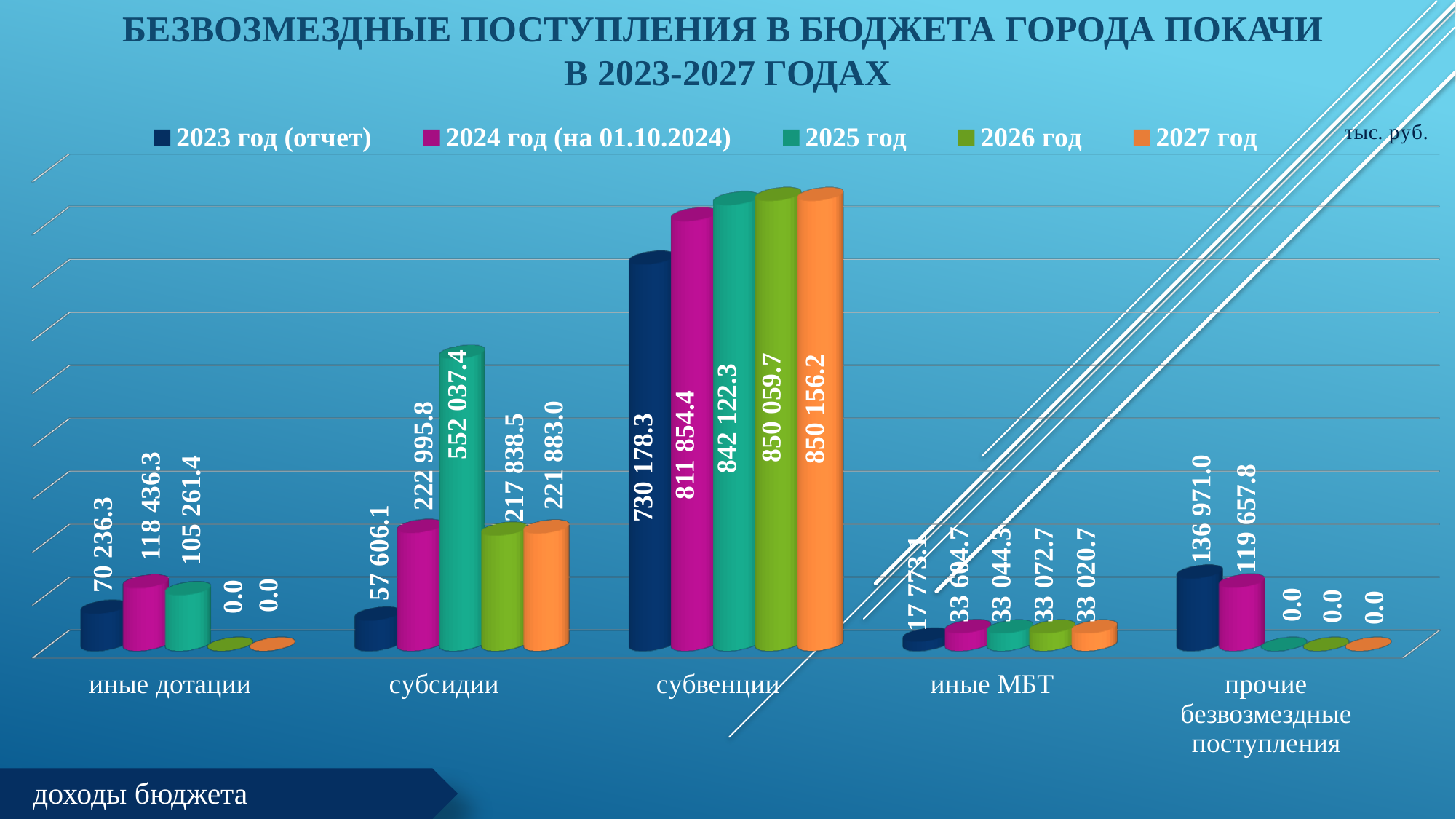
Which category has the lowest value for 2024 год (на 01.10.2024)? иные МБТ Which category has the highest value for 2027 год? субвенции What kind of chart is shown on the slide? bar chart What is the difference between the субвенции values for 2027 год and 2023 год (отчет)? 119 977.9 How many categories are shown on the x axis? 5 How many series does the legend list? 5 For иные дотации, which is larger: the value for 2024 год (на 01.10.2024) or for 2025 год? 2024 год (на 01.10.2024) What is the value for субвенции in 2025 год? 842 122.3 What is the value for прочие безвозмездные поступления in 2027 год? 0.0 What is the value for иные дотации in 2023 год (отчет)? 70 236.3 Do the values for субвенции rise or fall from 2023 год to 2027 год? rise What is the value for субсидии in 2025 год? 552 037.4